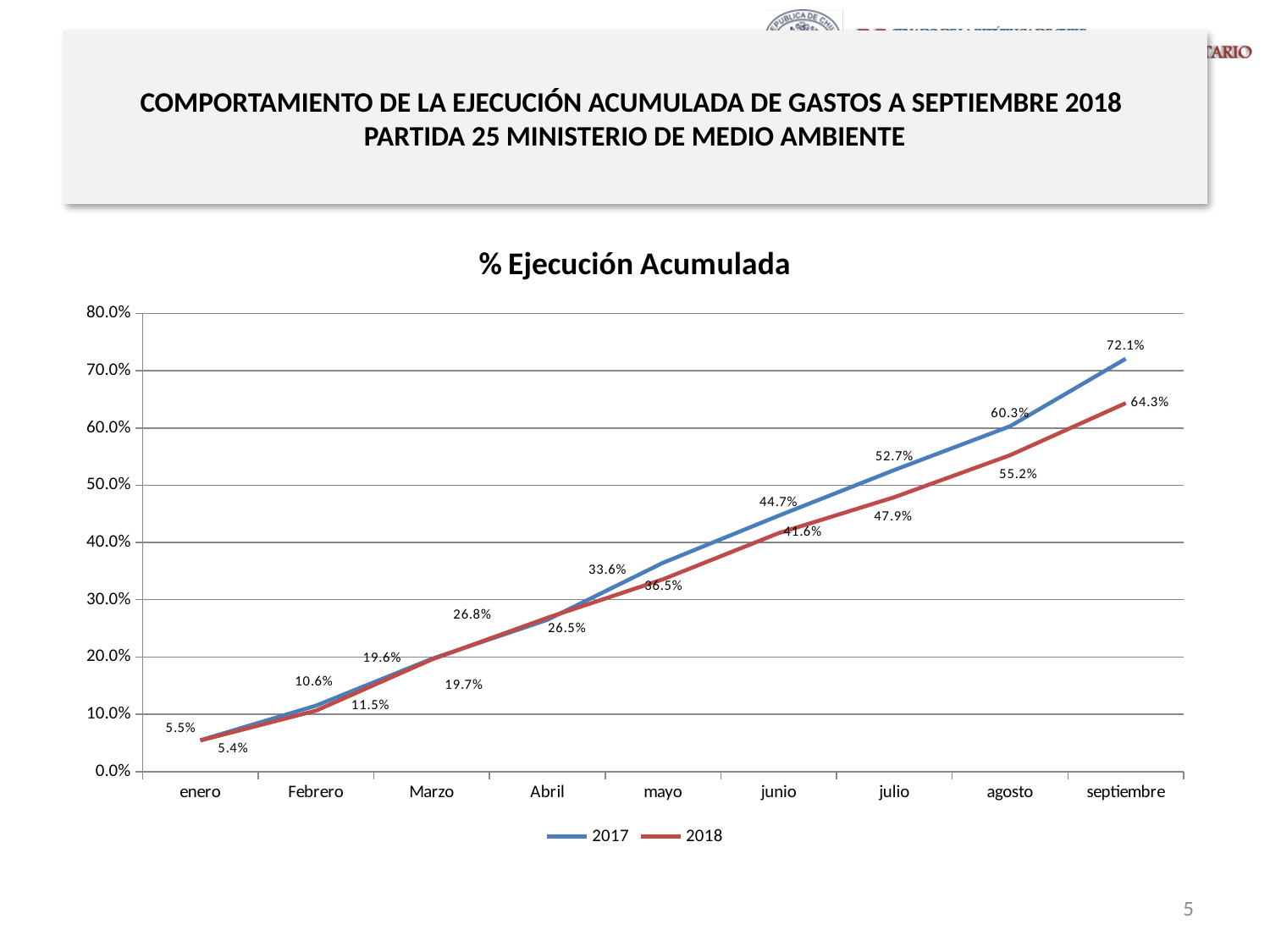
What is the value for 2018 in julio? 47.9% How many series does the legend list? 2 How many months are shown on the x axis? 9 What is the value for 2018 in septiembre? 64.3% What is the value for 2017 in septiembre? 72.1% What is the difference between the 2017 and 2018 values in septiembre? 7.8 percentage points In which month does the 2017 series reach its highest value? septiembre In which month is the 2018 series at its lowest value? enero Do the values for 2018 rise or fall from enero to septiembre? rise In agosto, which series has the higher value, 2017 or 2018? 2017 What kind of chart is shown? line chart What is the value for 2017 in enero? 5.5%